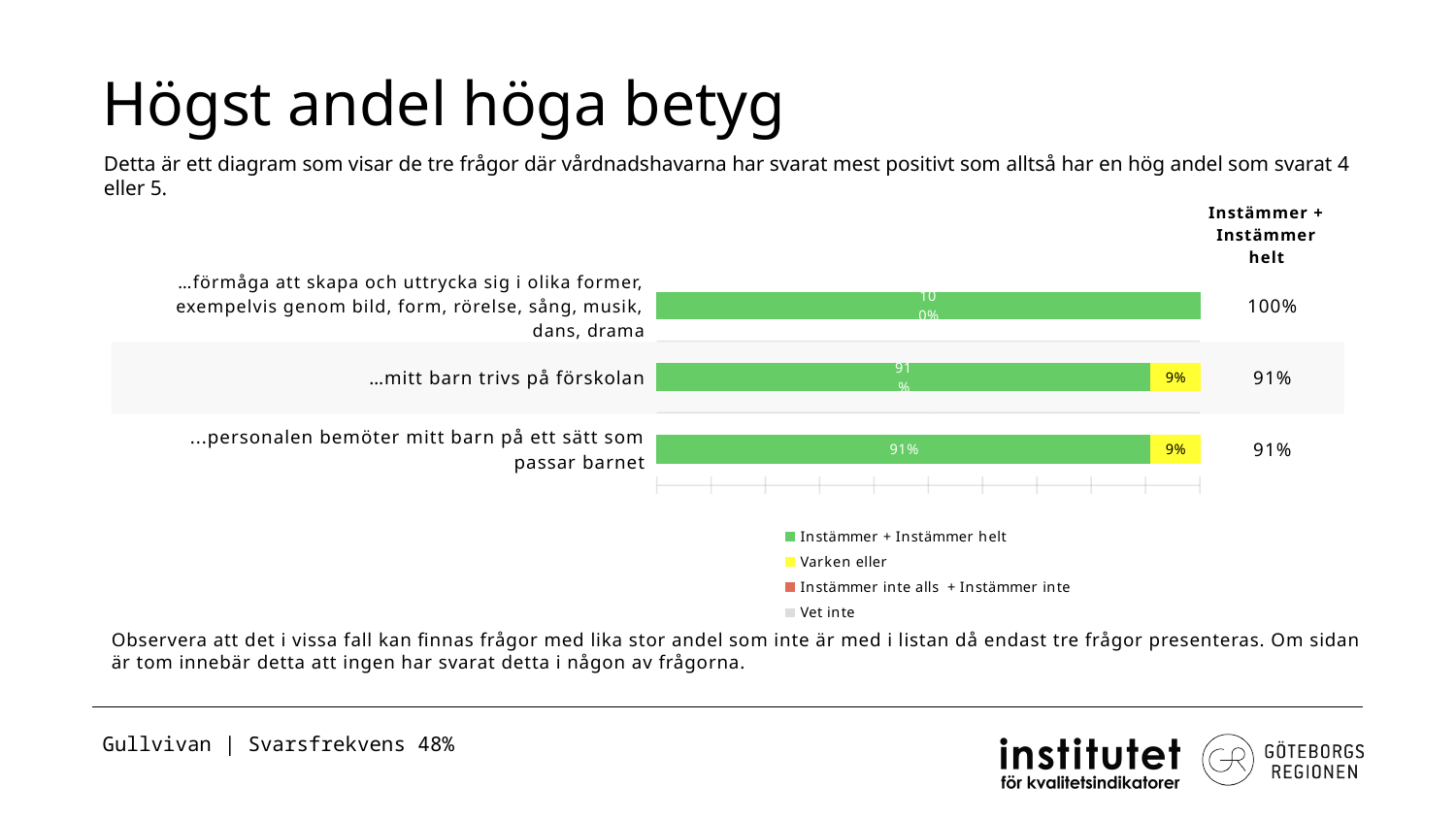
Which question has the highest share of 'Instämmer + Instämmer helt'? …förmåga att skapa och uttrycka sig i olika former, exempelvis genom bild, form, rörelse, sång, musik, dans, drama Which is larger: the 'Instämmer + Instämmer helt' share for '…förmåga att skapa och uttrycka sig i olika former…' or for '...personalen bemöter mitt barn på ett sätt som passar barnet'? …förmåga att skapa och uttrycka sig i olika former… What is the 'Instämmer + Instämmer helt' value for '…mitt barn trivs på förskolan'? 91% What is the 'Varken eller' value for '...personalen bemöter mitt barn på ett sätt som passar barnet'? 9% What is the title of the slide containing the chart? Högst andel höga betyg What is the 'Varken eller' value for '…mitt barn trivs på förskolan'? 9% How many series does the legend list? 4 What is the 'Instämmer + Instämmer helt' value for '…förmåga att skapa och uttrycka sig i olika former, exempelvis genom bild, form, rörelse, sång, musik, dans, drama'? 100% What is the difference in 'Instämmer + Instämmer helt' between '…förmåga att skapa och uttrycka sig i olika former…' and '…mitt barn trivs på förskolan'? 9% How many questions (categories) are shown in the chart? 3 Which legend entry is shown in yellow? Varken eller What kind of chart is shown on the slide? bar chart